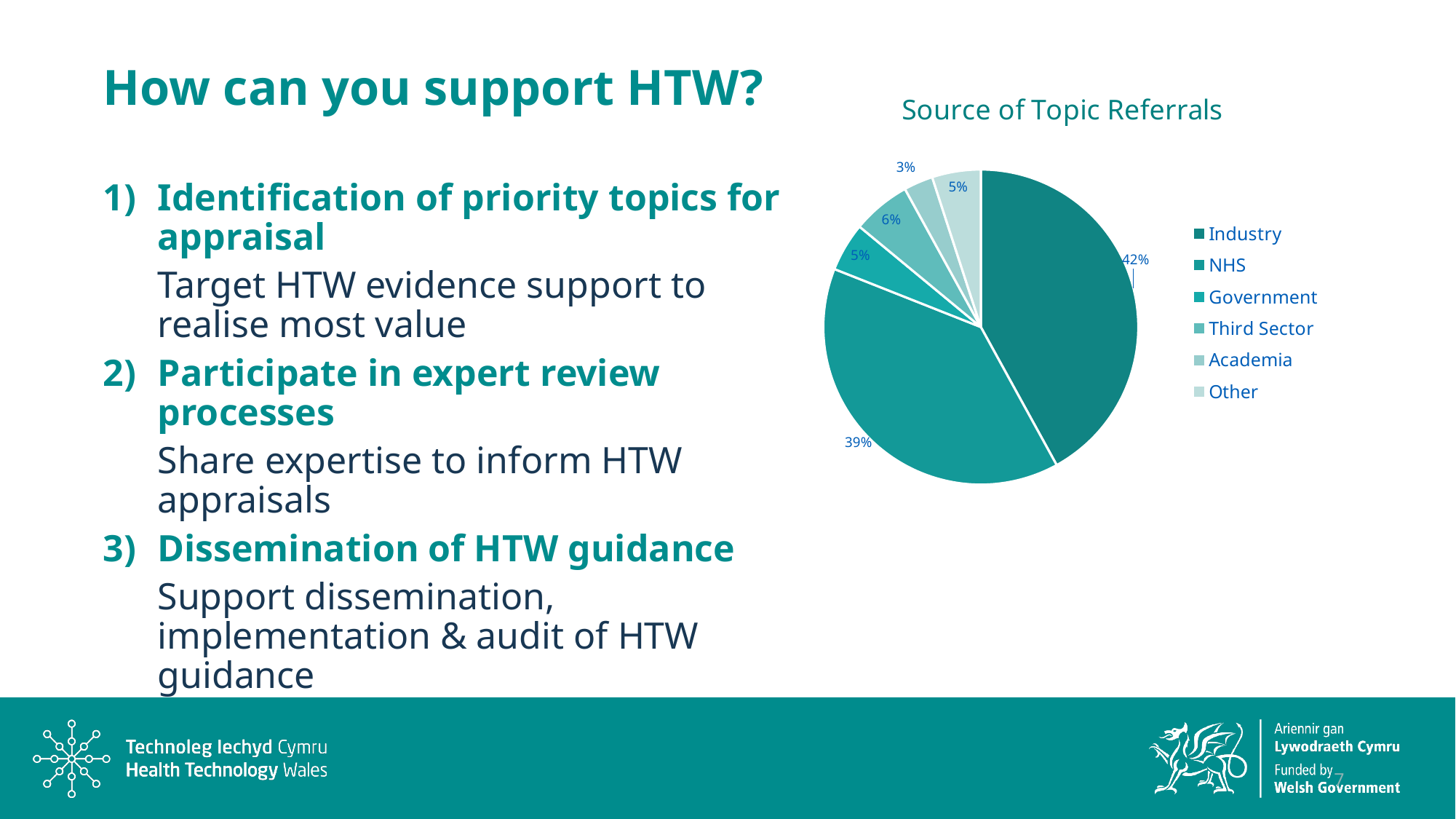
What share of topic referrals comes from the Third Sector? 6% What percentage of topic referrals comes from the NHS? 39% How many sources of topic referrals are shown in the pie chart? 6 Which source accounts for the smallest share of topic referrals? Academia What is the title of the chart on the slide? Source of Topic Referrals What percentage of topic referrals comes from Academia? 3% Which source accounts for the largest share of topic referrals? Industry Which has a larger share of topic referrals, Third Sector or Academia? Third Sector What type of chart is used to show the source of topic referrals? Pie chart How many percentage points larger is the Industry share than the NHS share? 3% What share of topic referrals comes from Industry? 42% What is the combined share of topic referrals from Industry and the NHS? 81%